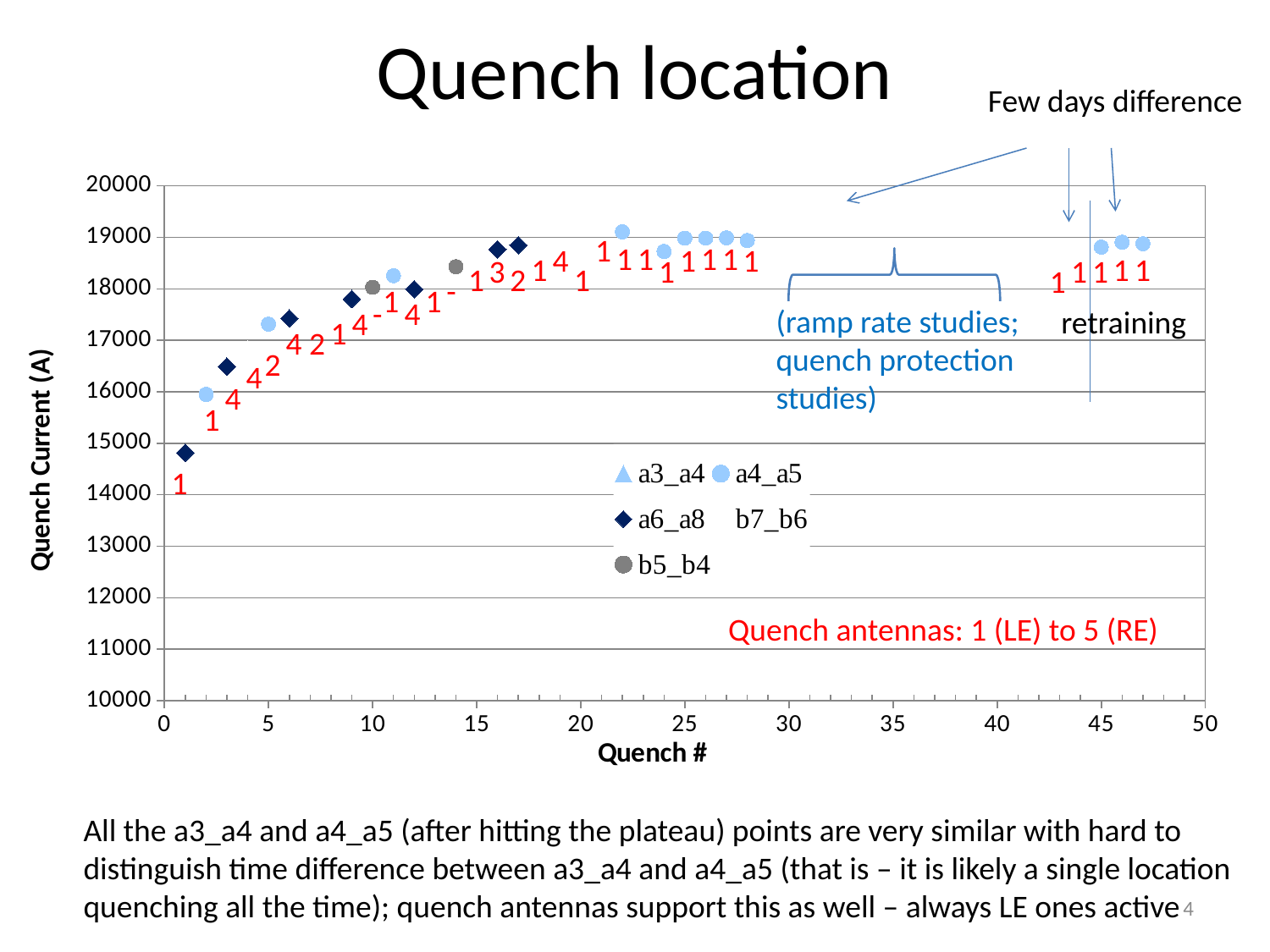
Is the quench current for quench #1 greater or less than 15000? less Is the quench current for quench #3 greater or less than 16000? greater Is the quench current for quench #17 greater or less than 19000? less Which quench has the lowest quench current on the chart? Quench #1 Which has the higher quench current, quench #1 or quench #17? Quench #17 What is the title of the chart's y axis? Quench Current (A) How many series does the chart legend list? 5 What is the title of the chart's x axis? Quench # What kind of chart is shown on the slide? scatter chart Does the quench current generally rise or fall as the quench number increases from 1 to 17? rise